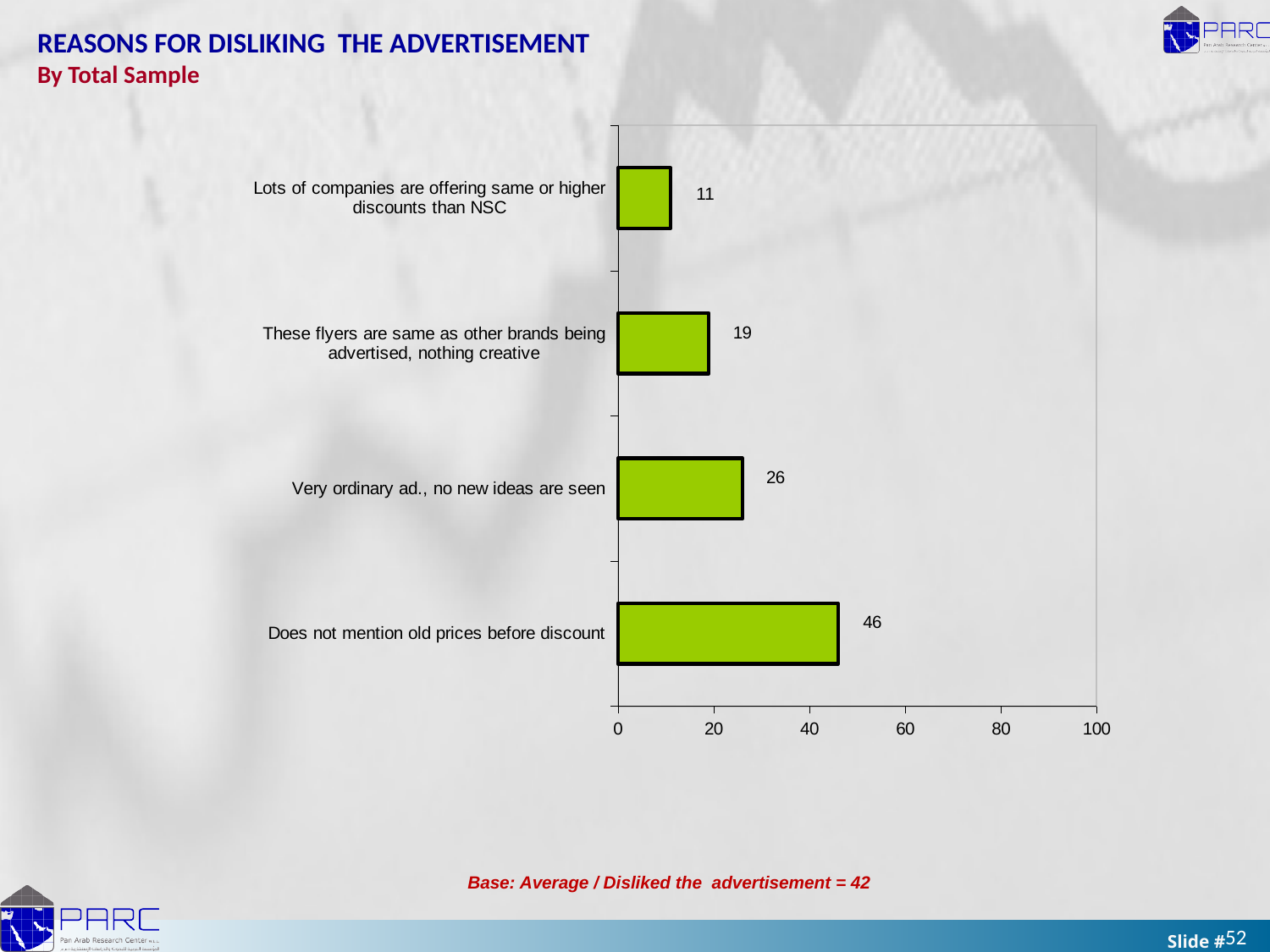
How many reasons are shown in the chart? 4 Is the value for "Does not mention old prices before discount" greater or less than 40? greater Which is larger: the value for "These flyers are same as other brands being advertised, nothing creative" or the value for "Lots of companies are offering same or higher discounts than NSC"? These flyers are same as other brands being advertised, nothing creative What is the value for "Very ordinary ad., no new ideas are seen"? 26 What is the value for "These flyers are same as other brands being advertised, nothing creative"? 19 What is the value for "Lots of companies are offering same or higher discounts than NSC"? 11 What is the value for "Does not mention old prices before discount"? 46 What is the difference between the values for "Does not mention old prices before discount" and "Very ordinary ad., no new ideas are seen"? 20 What kind of chart is shown on the slide? Bar chart What is the title of the chart on the slide? REASONS FOR DISLIKING THE ADVERTISEMENT Which reason has the highest value? Does not mention old prices before discount Which reason has the lowest value? Lots of companies are offering same or higher discounts than NSC